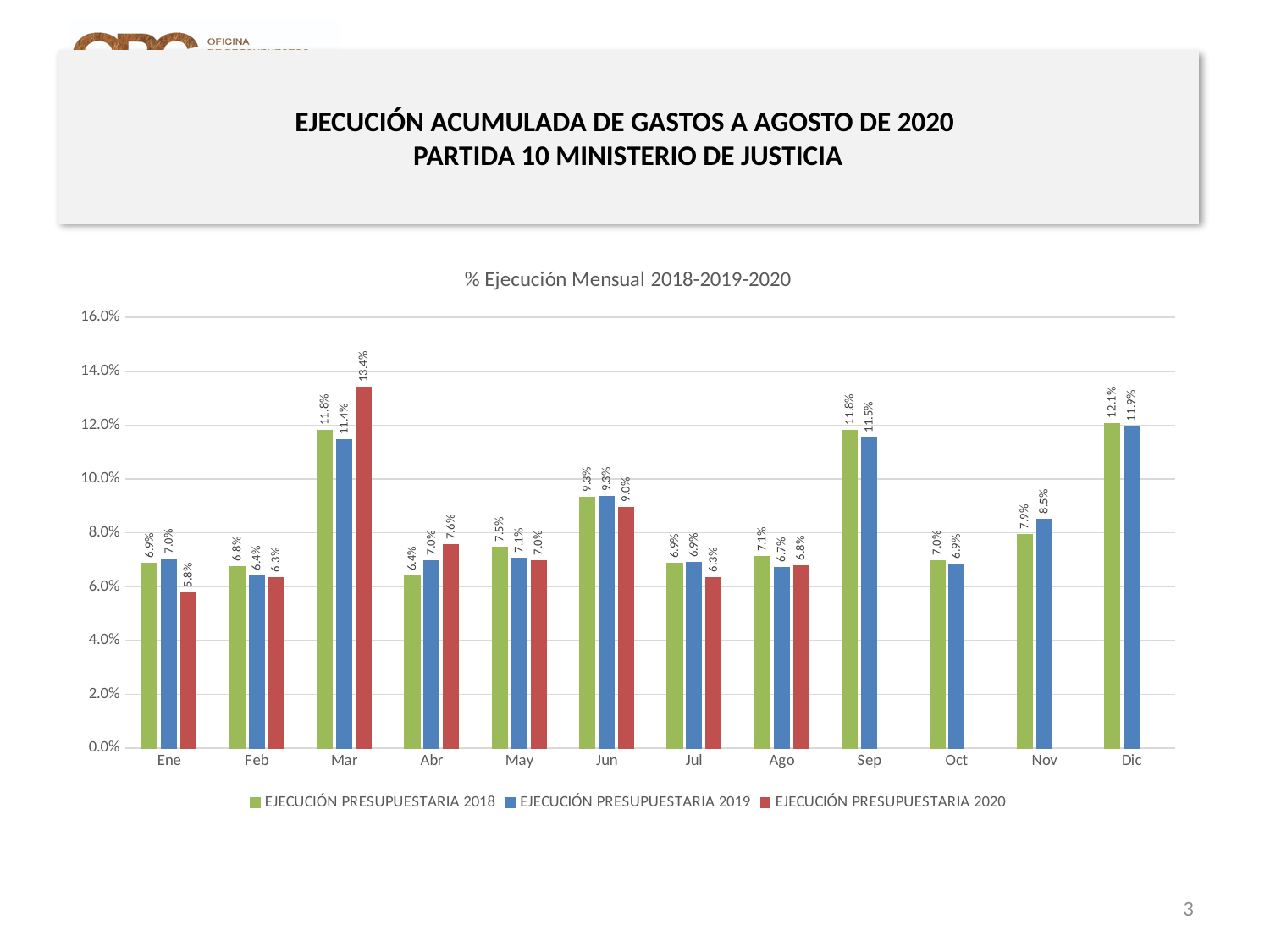
What is the title of the chart? % Ejecución Mensual 2018-2019-2020 Which month has the highest value for EJECUCIÓN PRESUPUESTARIA 2018? Dic Which is larger in Abr: EJECUCIÓN PRESUPUESTARIA 2018 or EJECUCIÓN PRESUPUESTARIA 2020? EJECUCIÓN PRESUPUESTARIA 2020 What is the value for EJECUCIÓN PRESUPUESTARIA 2019 in Nov? 8.5% How many months are shown on the x axis? 12 Which month has the lowest value for EJECUCIÓN PRESUPUESTARIA 2020? Ene Which month has the highest value for EJECUCIÓN PRESUPUESTARIA 2020? Mar What is the value for EJECUCIÓN PRESUPUESTARIA 2020 in Mar? 13.4% How many series does the legend list? 3 What is the difference between the EJECUCIÓN PRESUPUESTARIA 2020 and EJECUCIÓN PRESUPUESTARIA 2018 values in Mar? 1.6% What kind of chart is shown on the slide? Bar chart What is the value for EJECUCIÓN PRESUPUESTARIA 2018 in Dic? 12.1%